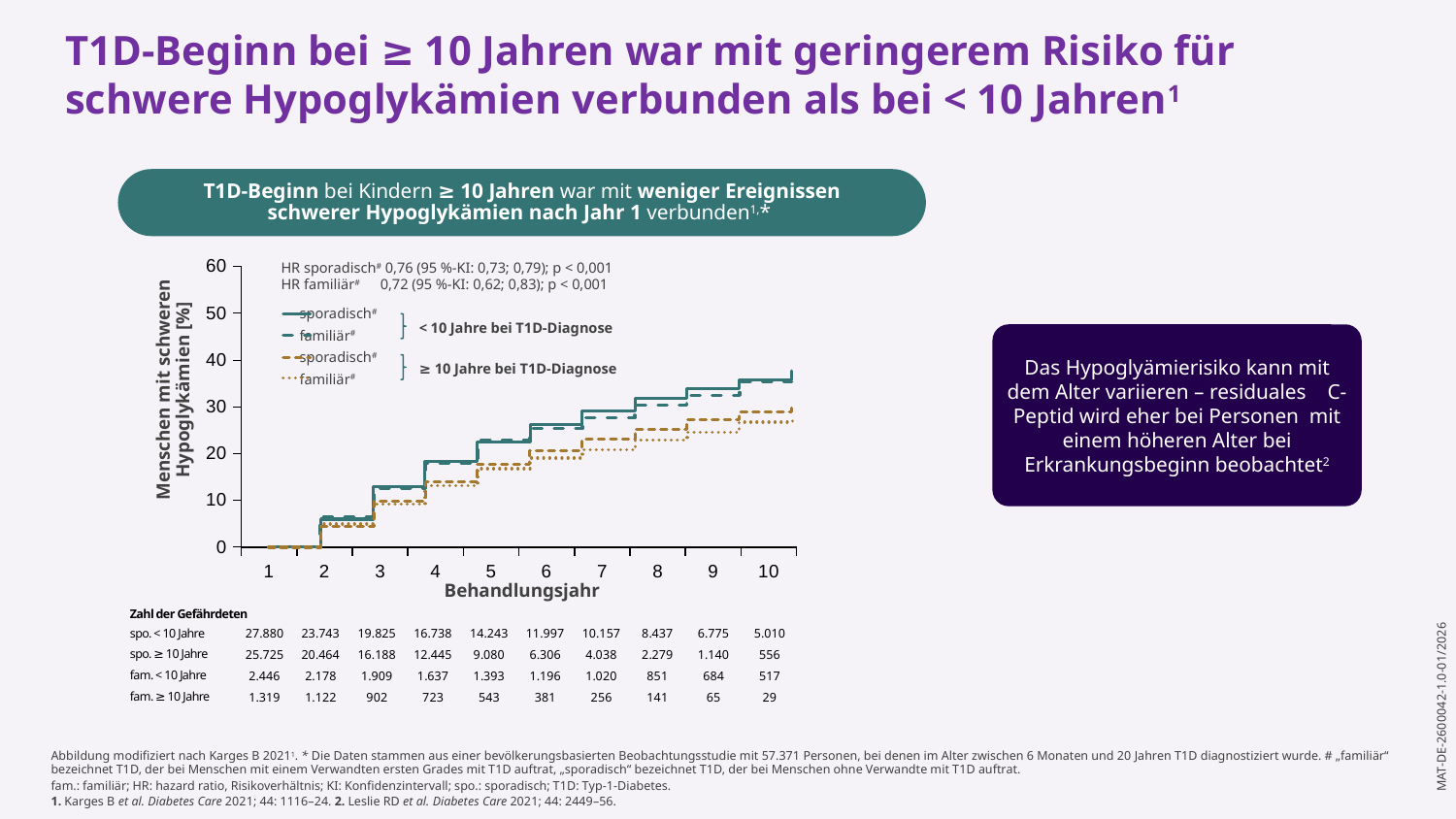
How many treatment years (Behandlungsjahr) are shown on the x axis? 10 What hazard ratio is given for 'familiär' in the chart annotation? 0,72 At treatment year 10, which is larger: the value for 'sporadisch, < 10 Jahre' or 'sporadisch, ≥ 10 Jahre'? sporadisch, < 10 Jahre What is the label of the y axis? Menschen mit schweren Hypoglykämien [%] What hazard ratio is given for 'sporadisch' in the chart annotation? 0,76 Do the plotted values rise or fall as the treatment year increases? rise Is the value for 'familiär, ≥ 10 Jahre bei T1D-Diagnose' at treatment year 10 greater or less than 30? less In the 'Zahl der Gefährdeten' table, how many people are at risk in the 'fam. ≥ 10 Jahre' group at treatment year 10? 29 How many series does the chart's legend list? 4 Is the value for 'sporadisch, < 10 Jahre bei T1D-Diagnose' at treatment year 10 greater or less than 30? greater What kind of chart is shown on the slide? line chart In the 'Zahl der Gefährdeten' table, how many people are at risk in the 'spo. < 10 Jahre' group at treatment year 1? 27.880